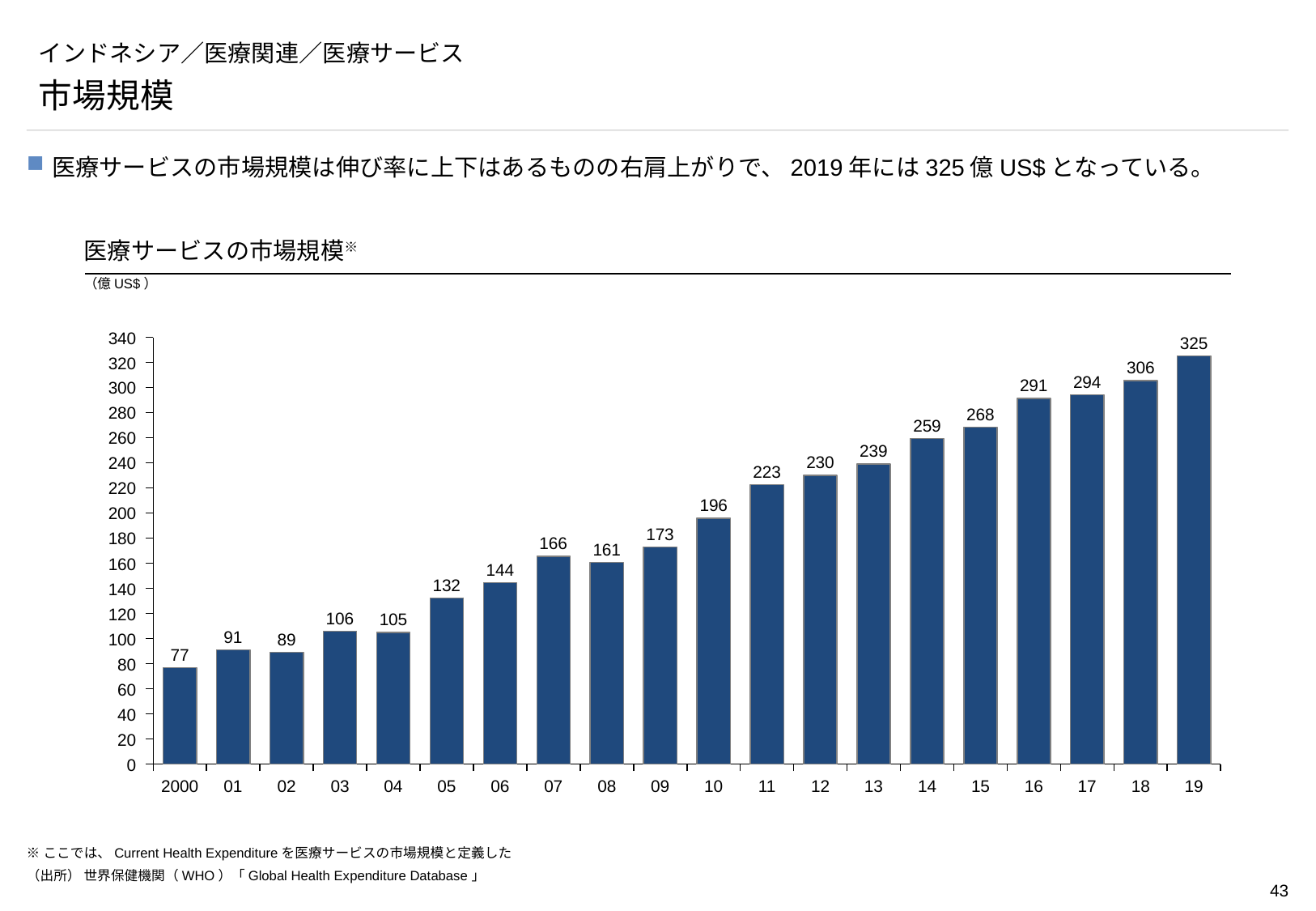
What is the difference between the values for 03 and 04? 1 What is the difference between the values for 2019 and 2000? 248 Which is larger, the value for 07 or the value for 08? 07 What is the value shown for 2000? 77 Which year has the highest value? 19 How many years (bars) are plotted in the chart? 20 Do the values generally rise or fall from 2000 to 2019? rise What kind of chart is shown on the slide? bar chart Which year has the lowest value? 2000 What is the value shown for 2010? 196 What unit is given for the chart's values? 億US$ What is the market size value shown for 2019? 325